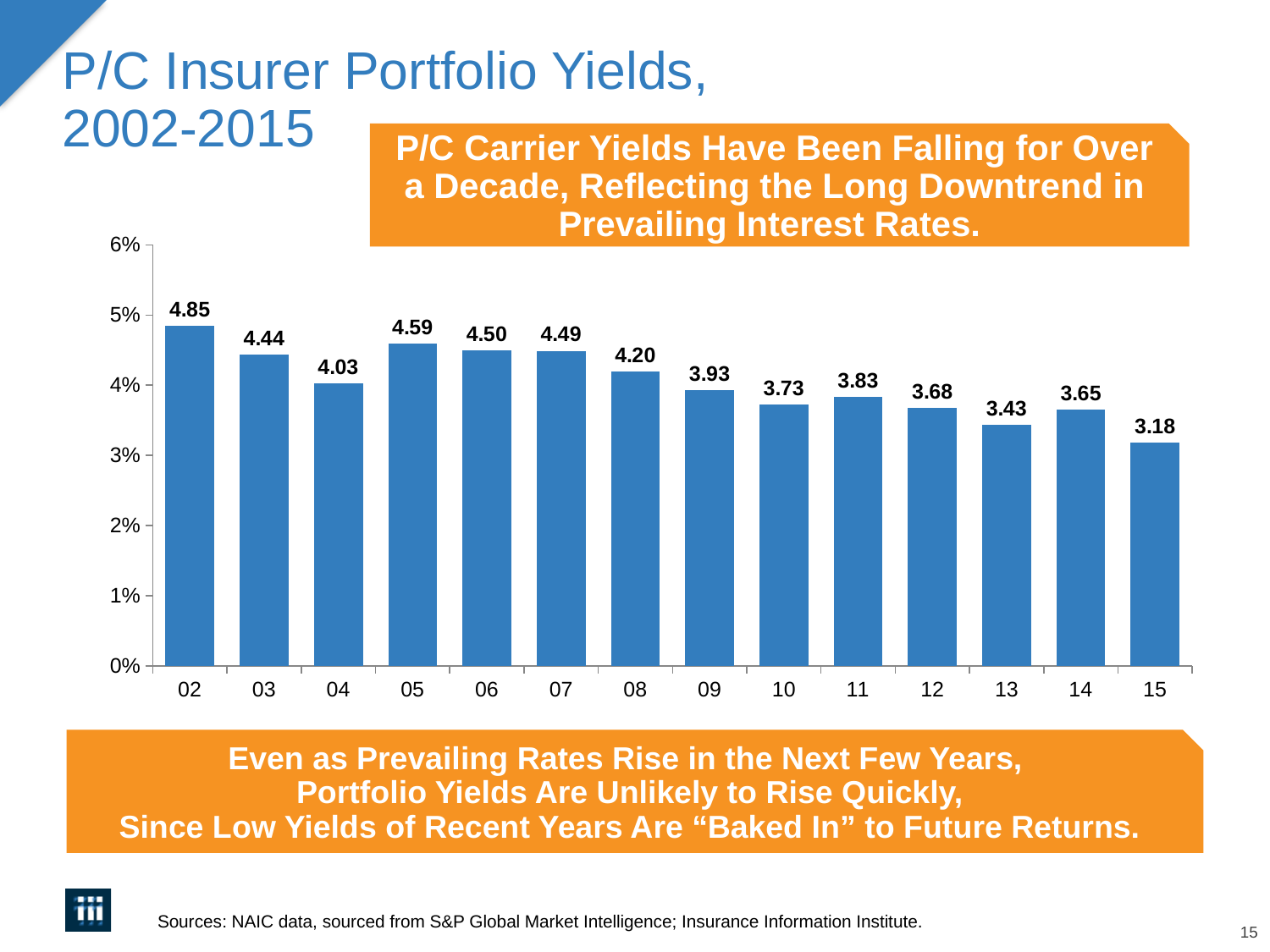
How many years are shown on the x axis? 14 What kind of chart is shown on the slide? bar chart Which year has the lowest portfolio yield? 15 Which is larger, the value for 2011 (11) or the value for 2012 (12)? 11 Do the portfolio yields generally rise or fall from 2002 to 2015? fall Is the value for 2013 (13) greater or less than 4%? less What is the portfolio yield value shown for 2002 (label 02)? 4.85 Which year has the highest portfolio yield? 02 What is the value shown for 2015 (label 15)? 3.18 What is the difference between the values for 2002 (02) and 2015 (15)? 1.67 What is the title of the chart on the slide? P/C Insurer Portfolio Yields, 2002-2015 What is the value shown for 2008 (label 08)? 4.20